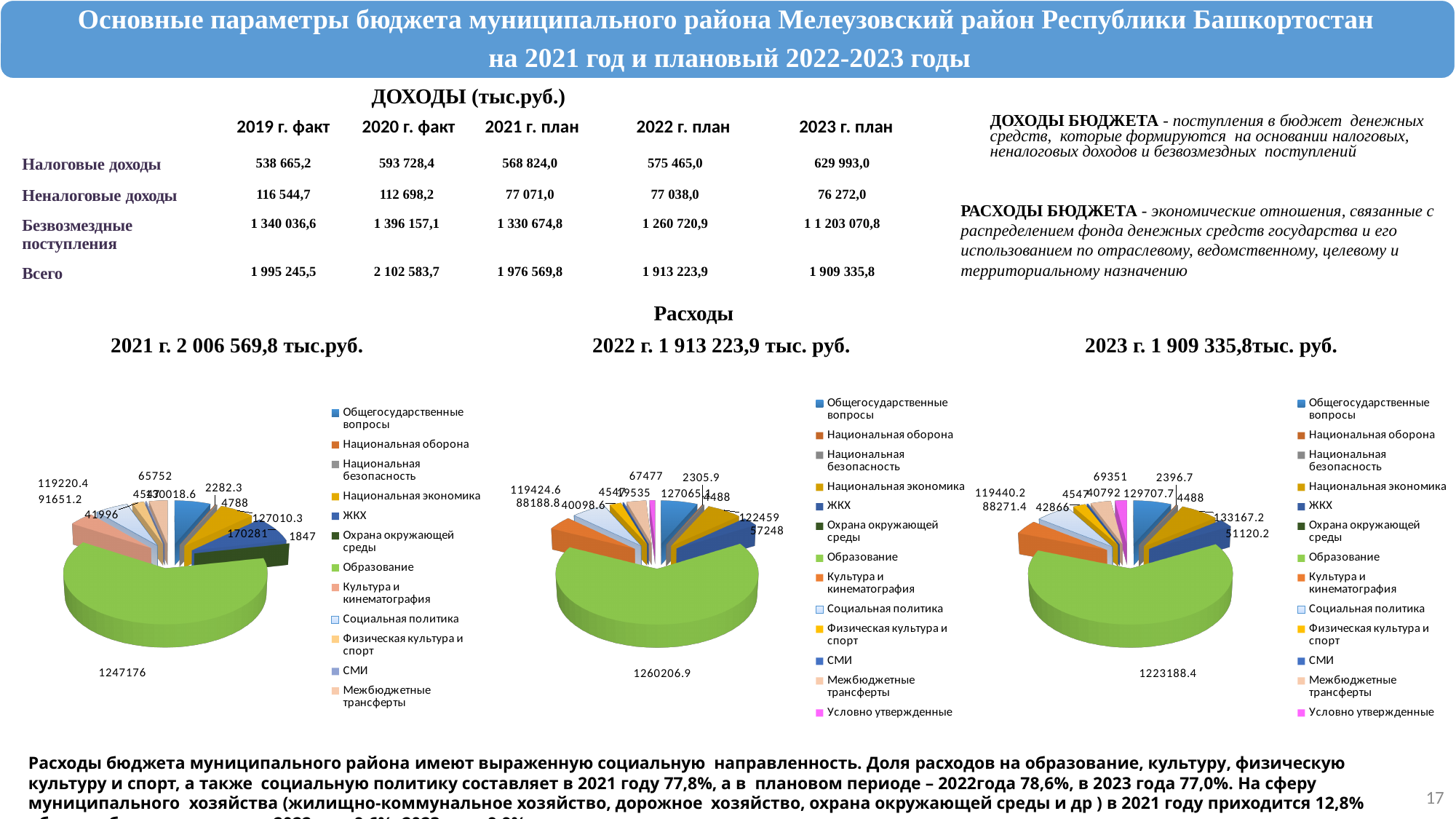
How many categories does the legend of the 2021 expenditures chart (left) list? 12 In the 2023 expenditures chart (right), which category has the largest slice? Образование Which legend entry appears in the 2022 and 2023 expenditure charts but not in the 2021 chart? Условно утвержденные In the 2023 expenditures chart (right), what is the value shown for Образование? 1223188.4 What type of chart is used to show the 2021 expenditures (left chart)? pie chart How many categories does the legend of the 2022 expenditures chart (middle) list? 13 What total is given in the heading above the 2022 expenditures chart (middle)? 2022 г. 1 913 223,9 тыс. руб. In the 2021 expenditures chart (left), which category has the largest slice? Образование Is the value for Образование larger in the 2022 chart (middle) or in the 2023 chart (right)? 2022 chart In the 2021 expenditures chart (left), what is the value shown for Образование? 1247176 What is the difference between the Образование value in the 2022 chart (middle) and in the 2023 chart (right)? 37018.5 In the 2022 expenditures chart (middle), what is the value shown for Образование? 1260206.9